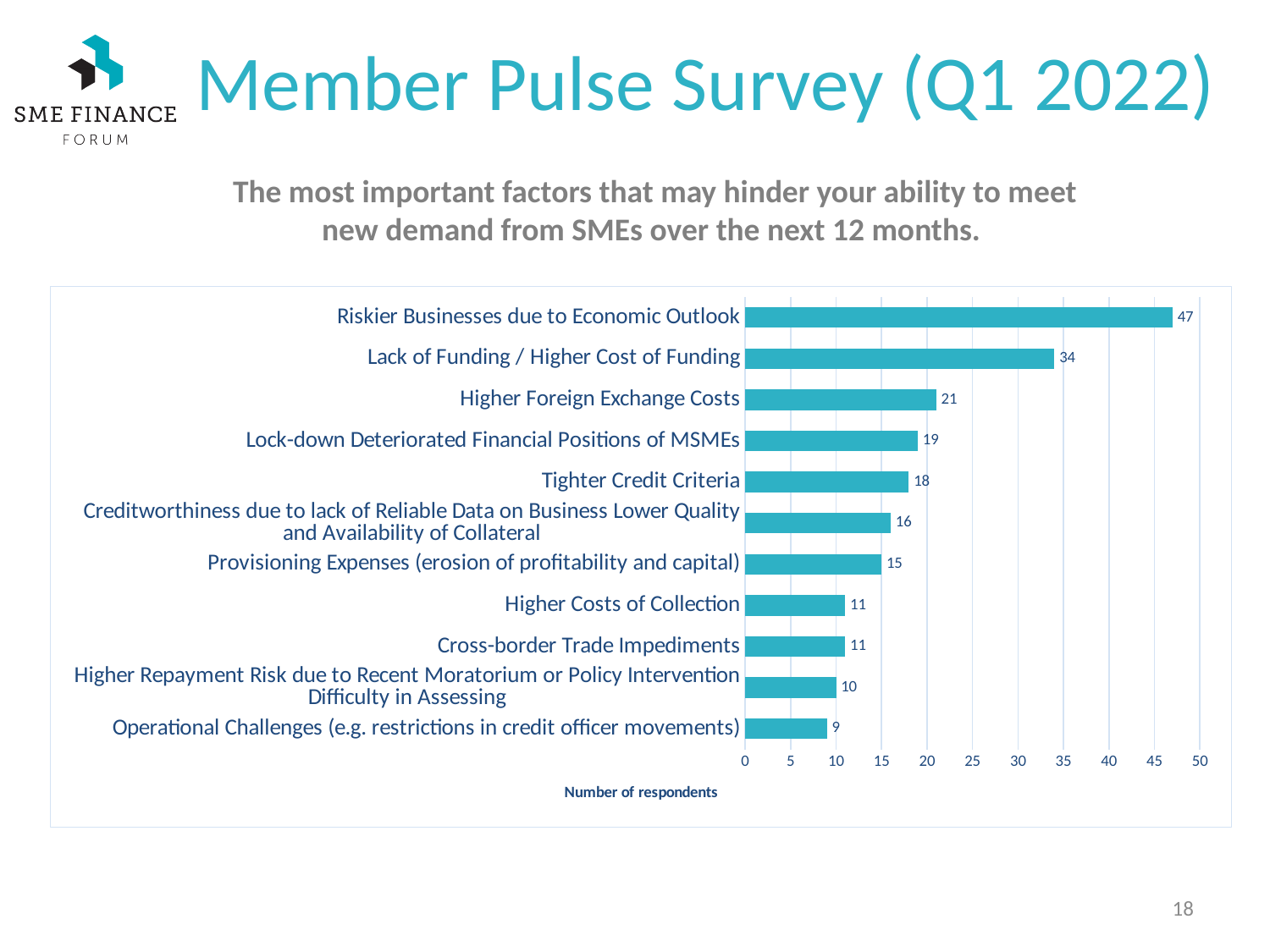
Which factor has the lowest number of respondents? Operational Challenges (e.g. restrictions in credit officer movements) What is the value for Operational Challenges (e.g. restrictions in credit officer movements)? 9 How many factors (categories) are shown in the chart? 11 Which factor has the highest number of respondents? Riskier Businesses due to Economic Outlook What is the number of respondents for Lack of Funding / Higher Cost of Funding? 34 What is the label of the horizontal axis? Number of respondents Which has more respondents: Higher Foreign Exchange Costs or Lock-down Deteriorated Financial Positions of MSMEs? Higher Foreign Exchange Costs What is the difference in respondents between Riskier Businesses due to Economic Outlook and Lack of Funding / Higher Cost of Funding? 13 What kind of chart is shown on the slide? Bar chart How many respondents cited Riskier Businesses due to Economic Outlook? 47 What is the value for Tighter Credit Criteria? 18 Is the value for Provisioning Expenses (erosion of profitability and capital) greater or less than 20? less